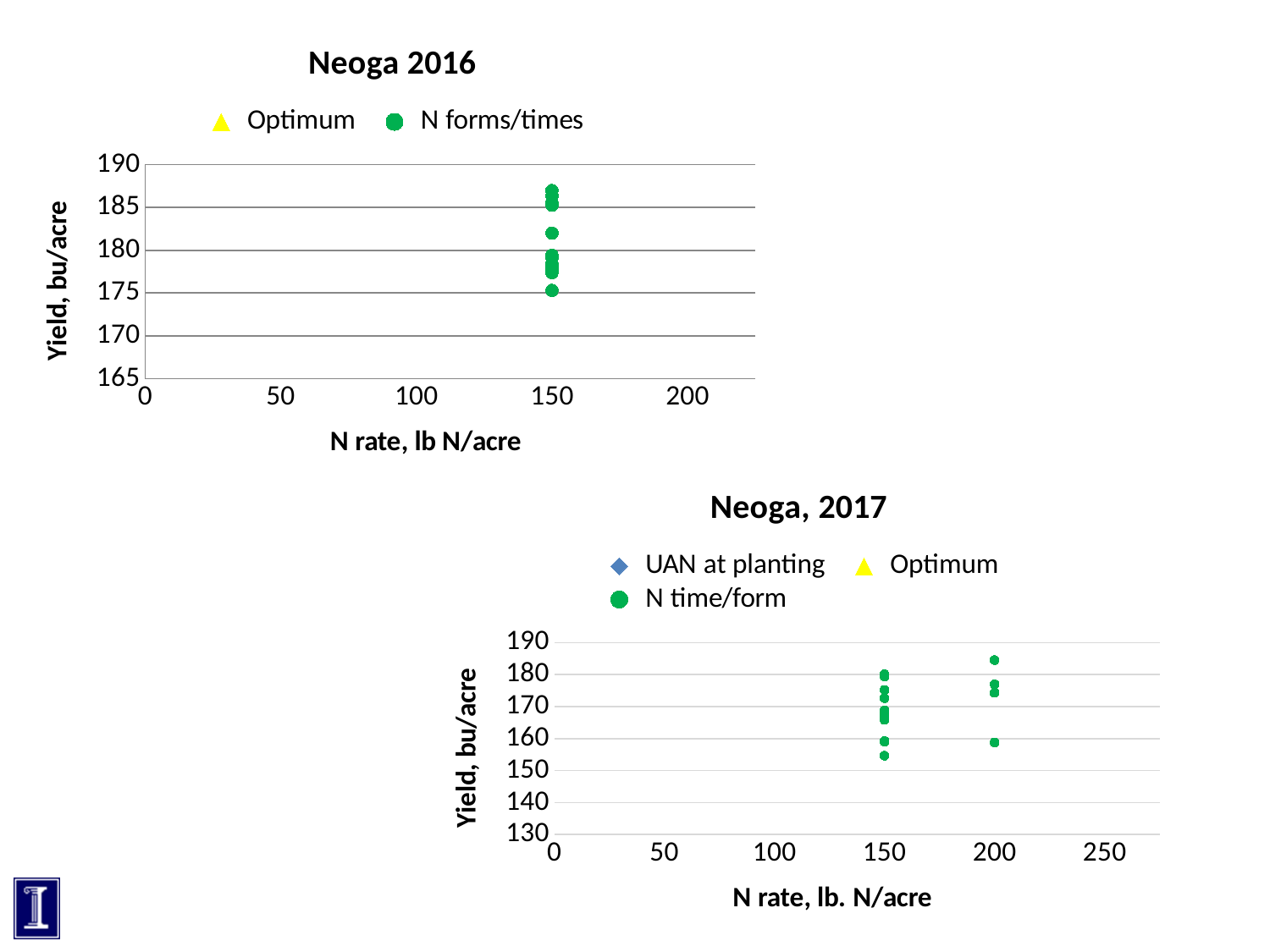
How many series does the legend of the Neoga 2016 chart list? 2 In the Neoga, 2017 chart, is the lowest yield value at an N rate of 150 greater or less than 160? less In the Neoga, 2017 chart, is the highest yield value at an N rate of 200 greater or less than 180? greater Which series in the Neoga, 2017 chart legend is shown with a yellow triangle marker? Optimum What is the y-axis title of the Neoga 2016 chart? Yield, bu/acre What kind of chart is the Neoga 2016 chart? scatter chart In the Neoga 2016 chart, at how many distinct N rates are points plotted? 1 In the Neoga 2016 chart, are all the plotted yield values greater or less than 190? less How many series does the legend of the Neoga, 2017 chart list? 3 In the Neoga, 2017 chart, at how many distinct N rates are points plotted? 2 What kind of chart is the Neoga, 2017 chart? scatter chart